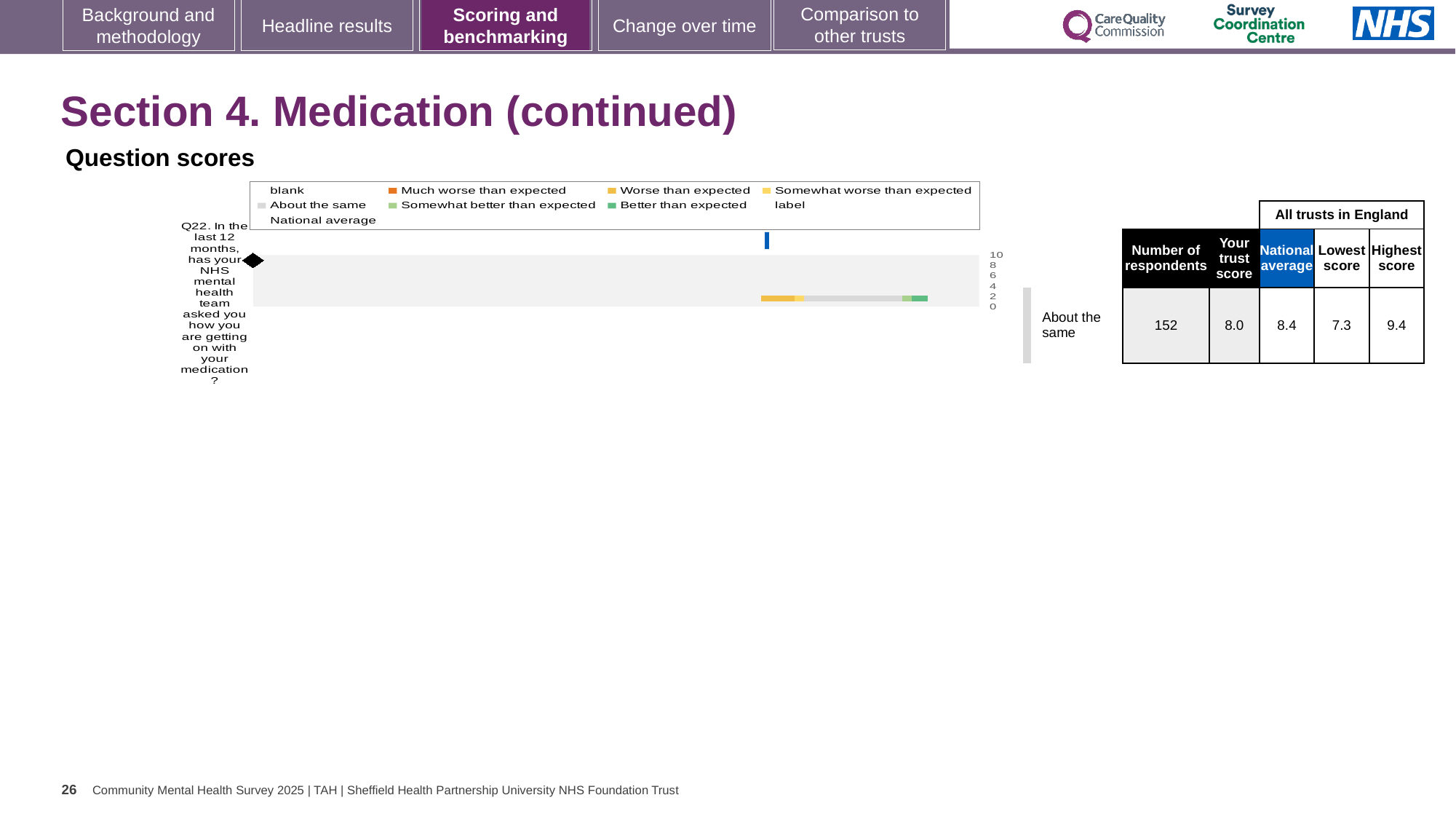
How many respondents answered Q22? 152 What is the lowest score among all trusts in England for Q22? 7.3 How many survey questions are plotted in the chart? 1 What colour does the legend use for 'Much worse than expected'? orange Which benchmarking category is Q22 placed in? About the same Which question is plotted in the chart? Q22. In the last 12 months, has your NHS mental health team asked you how you are getting on with your medication? What is the difference between the national average and the trust score for Q22? 0.4 What is the trust's score for Q22? 8.0 What is the highest score among all trusts in England for Q22? 9.4 What is the national average score for Q22? 8.4 Which is larger for Q22, the trust score or the national average? national average What kind of chart is shown under 'Question scores'? bar chart